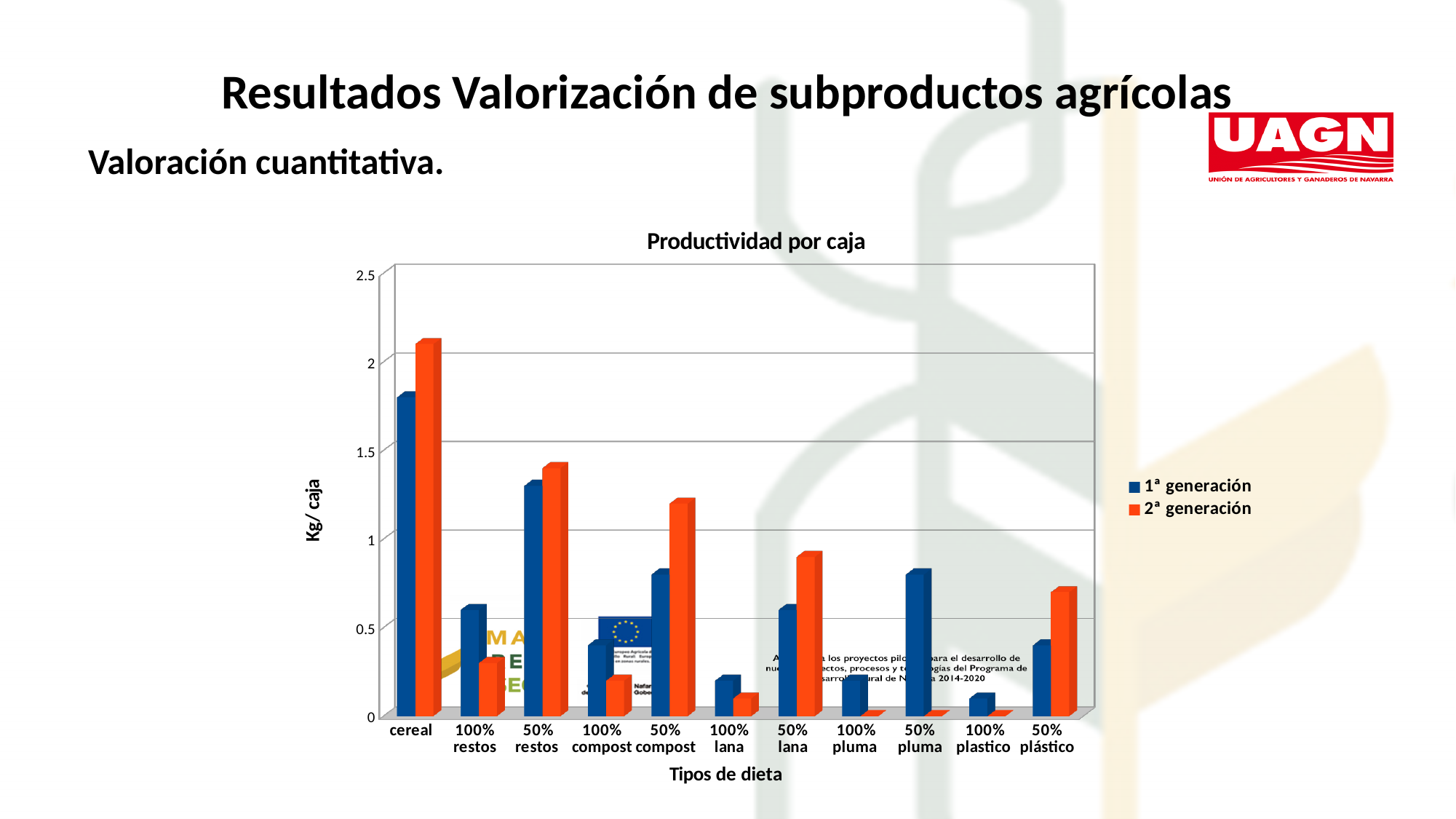
What is the label of the vertical axis of the chart? Kg/ caja What kind of chart is shown on the slide? bar chart For 100% restos, which series has the larger value, 1ª generación or 2ª generación? 1ª generación How many diet types (categories) are shown on the x axis of the 'Productividad por caja' chart? 11 Which diet type has the highest value for 1ª generación? cereal Is the 2ª generación value for cereal greater or less than 2? greater For 50% compost, which series has the larger value, 1ª generación or 2ª generación? 2ª generación Is the 2ª generación value for 100% compost greater or less than 0.5? less Is the 1ª generación value for 50% restos greater or less than 1? greater Which diet type has the highest value for 2ª generación? cereal What is the label of the horizontal axis of the chart? Tipos de dieta How many series does the legend of the 'Productividad por caja' chart list? 2